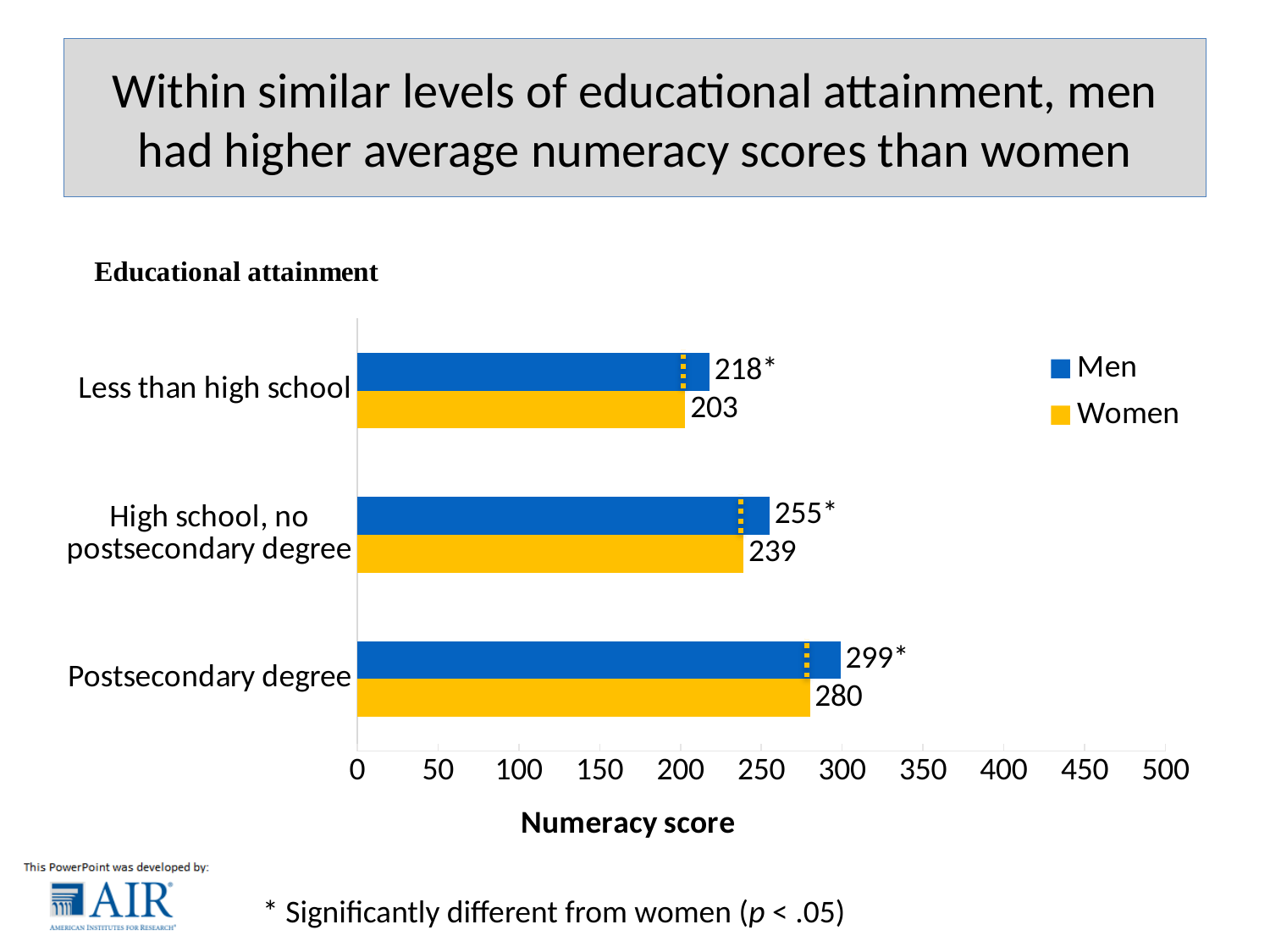
What is the average numeracy score for men with less than high school? 218 How many series does the legend list? 2 What is the difference between men's and women's numeracy scores for less than high school? 15 Which educational attainment level has the highest numeracy score for men? Postsecondary degree What is the label of the horizontal axis? Numeracy score What kind of chart is shown on the slide? Bar chart What is the average numeracy score for women with a postsecondary degree? 280 Which is larger: the numeracy score for men with high school, no postsecondary degree, or for women with a postsecondary degree? Women with a postsecondary degree What is the average numeracy score for women with high school, no postsecondary degree? 239 What is the difference between men's and women's numeracy scores for postsecondary degree? 19 Which educational attainment level has the lowest numeracy score for women? Less than high school How many educational attainment categories are shown in the chart? 3